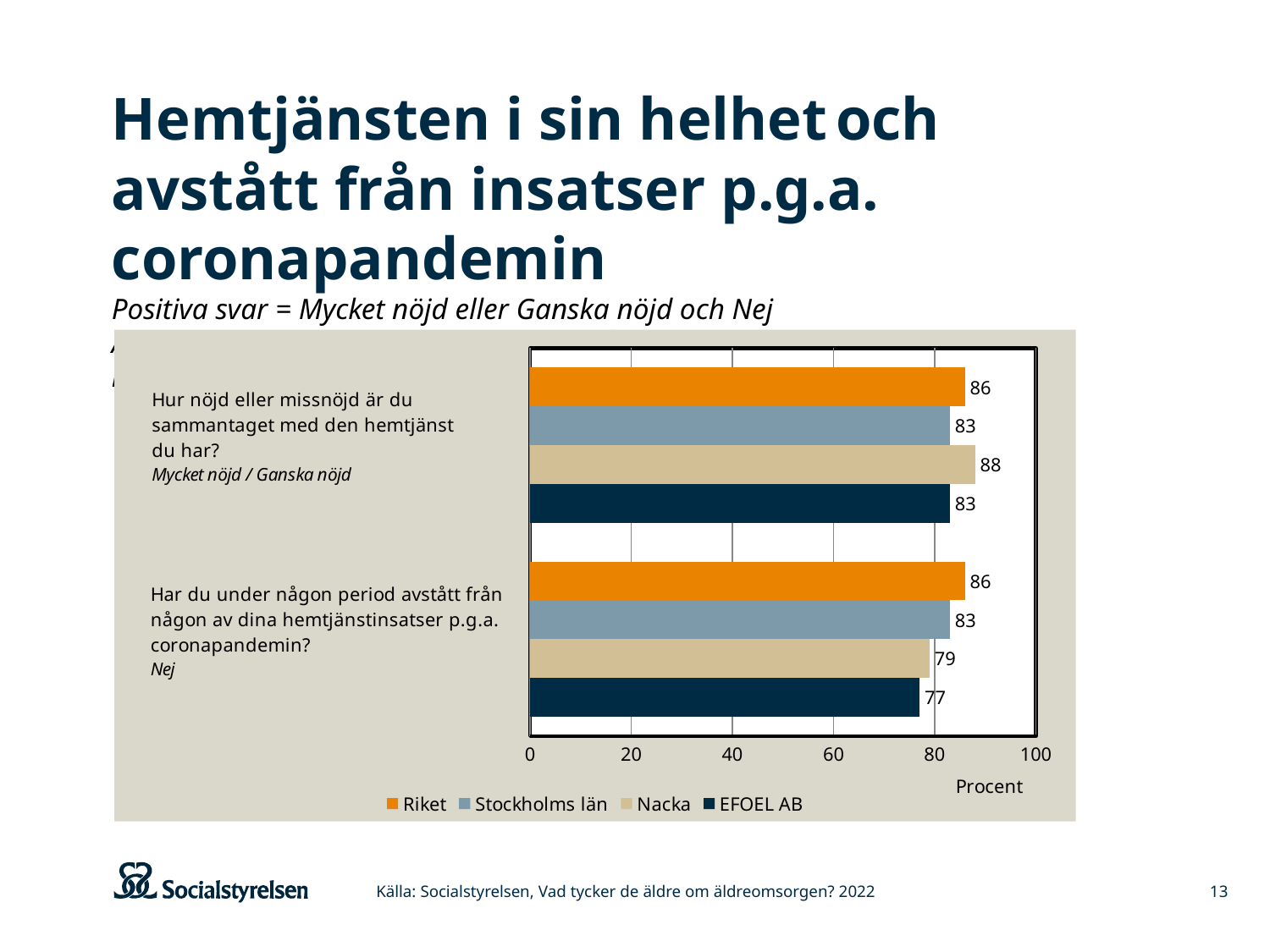
What is the value for EFOEL AB on the question "Har du under någon period avstått från någon av dina hemtjänstinsatser p.g.a. coronapandemin?"? 77 What is the value for Stockholms län on the question about overall satisfaction with home care? 83 Which series has the highest value on the question about overall satisfaction with home care? Nacka What type of chart is shown on the slide? bar chart How many question categories are shown on the chart? 2 What is the difference between the Nacka value and the EFOEL AB value on the question about overall satisfaction with home care? 5 What label is shown on the horizontal axis of the chart? Procent What is the value for Riket on the question about having refrained from home care services due to the corona pandemic? 86 Which series has the lowest value on the question about refraining from home care services due to the corona pandemic? EFOEL AB Which is larger on the question about refraining from home care services due to the corona pandemic: the value for Riket or the value for Nacka? Riket What is the value for Nacka on the question "Hur nöjd eller missnöjd är du sammantaget med den hemtjänst du har?"? 88 How many series does the legend list? 4